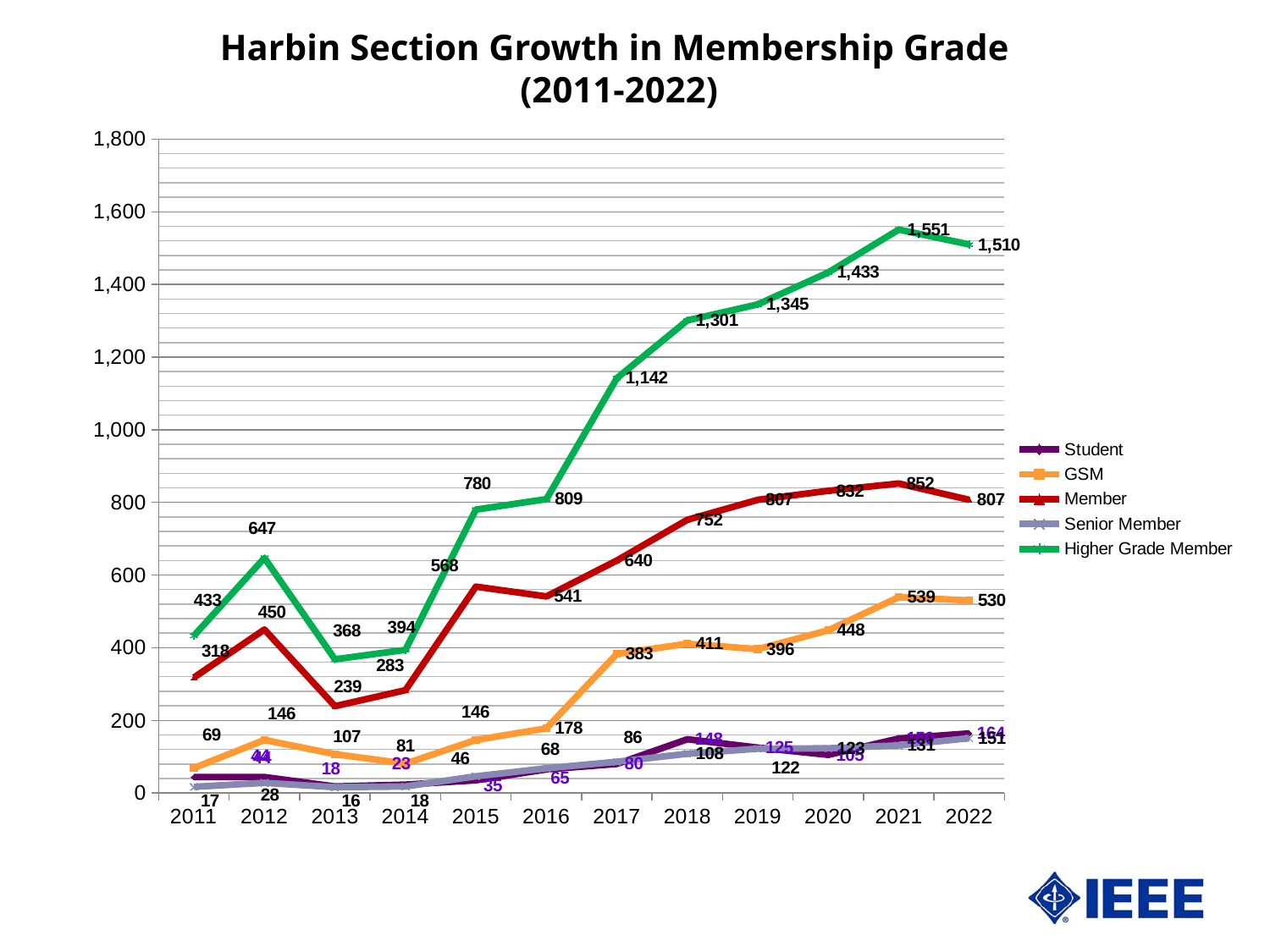
How many years are plotted along the x axis? 12 Which year has the larger Member value, 2015 or 2016? 2015 By how much did the Higher Grade Member value fall from 2021 to 2022? 41 How many series does the legend list? 5 Does the Higher Grade Member line rise or fall from 2017 to 2021? rise What is the Senior Member value for 2022? 151 What is the Higher Grade Member value for 2021? 1,551 In which year is the GSM value lowest? 2011 In which year is the Higher Grade Member value highest? 2021 What is the GSM value for 2017? 383 What is the Member value for 2018? 752 What kind of chart is shown on the slide? line chart